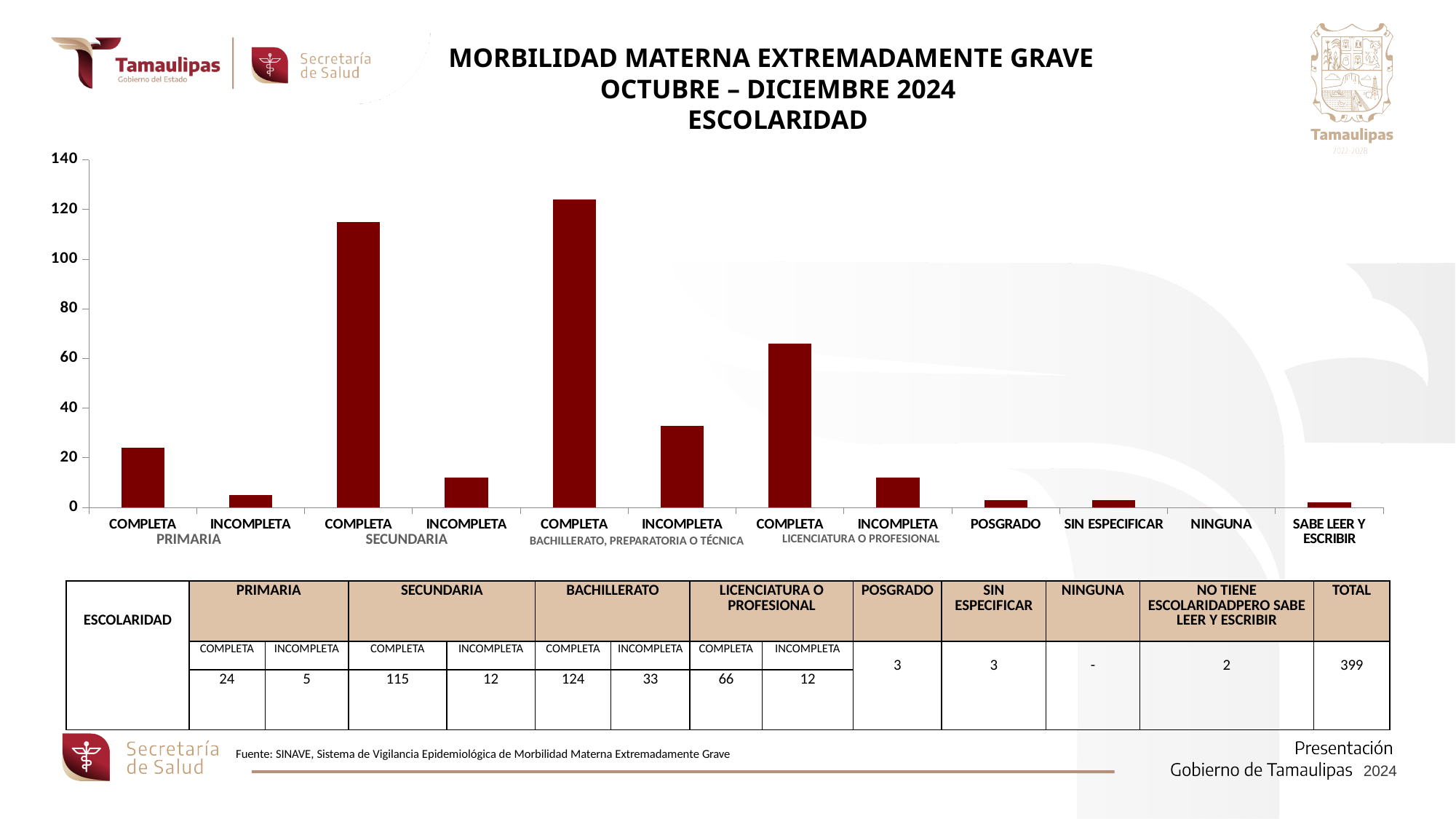
Which category has the highest bar in the chart? COMPLETA (Bachillerato, Preparatoria o Técnica) How many bars are plotted in the chart? 11 Which is larger, Primaria COMPLETA or Licenciatura o Profesional COMPLETA? Licenciatura o Profesional COMPLETA What is the value for Licenciatura o Profesional COMPLETA? 66 What is the value for Secundaria COMPLETA? 115 What is the value for Bachillerato INCOMPLETA? 33 What is the value for Primaria COMPLETA? 24 What is the difference between Bachillerato COMPLETA and Secundaria COMPLETA? 9 Is the value for Licenciatura o Profesional COMPLETA greater or less than 80? less Is the value for Secundaria COMPLETA greater or less than 100? greater What type of chart is shown on the slide? bar chart What is the total shown in the table for ESCOLARIDAD? 399